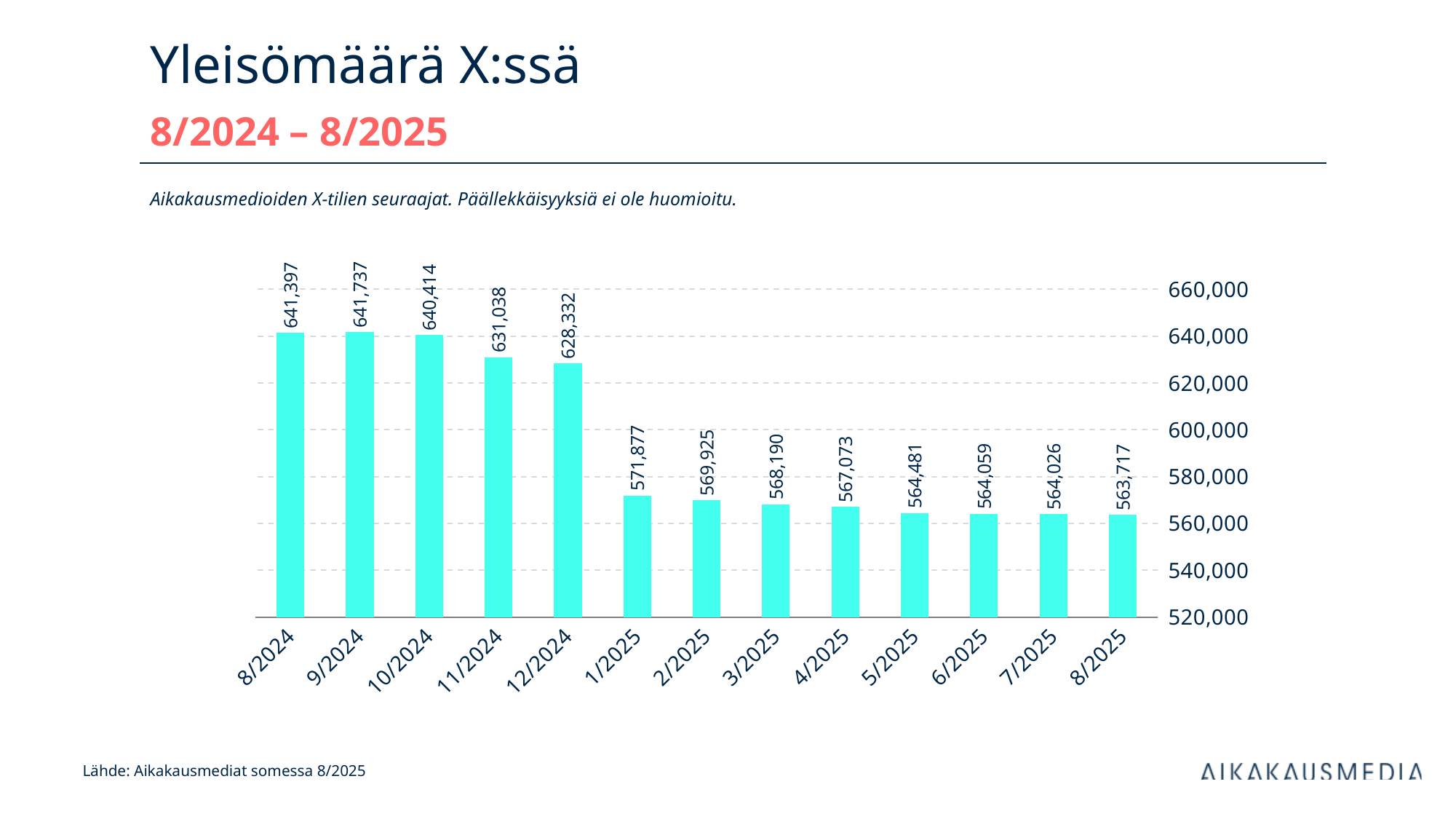
Do the values generally rise or fall from 8/2024 to 8/2025? Fall What is the value for 1/2025? 571,877 What kind of chart is shown on the slide? Bar chart What is the value for 8/2024? 641,397 Which month has the highest value? 9/2024 What is the value for 12/2024? 628,332 What is the difference between the values for 12/2024 and 1/2025? 56,455 What is the value for 8/2025? 563,717 Which is larger, the value for 11/2024 or the value for 2/2025? 11/2024 How many months are shown on the x axis? 13 Which month has the lowest value? 8/2025 What is the difference between the values for 8/2024 and 8/2025? 77,680